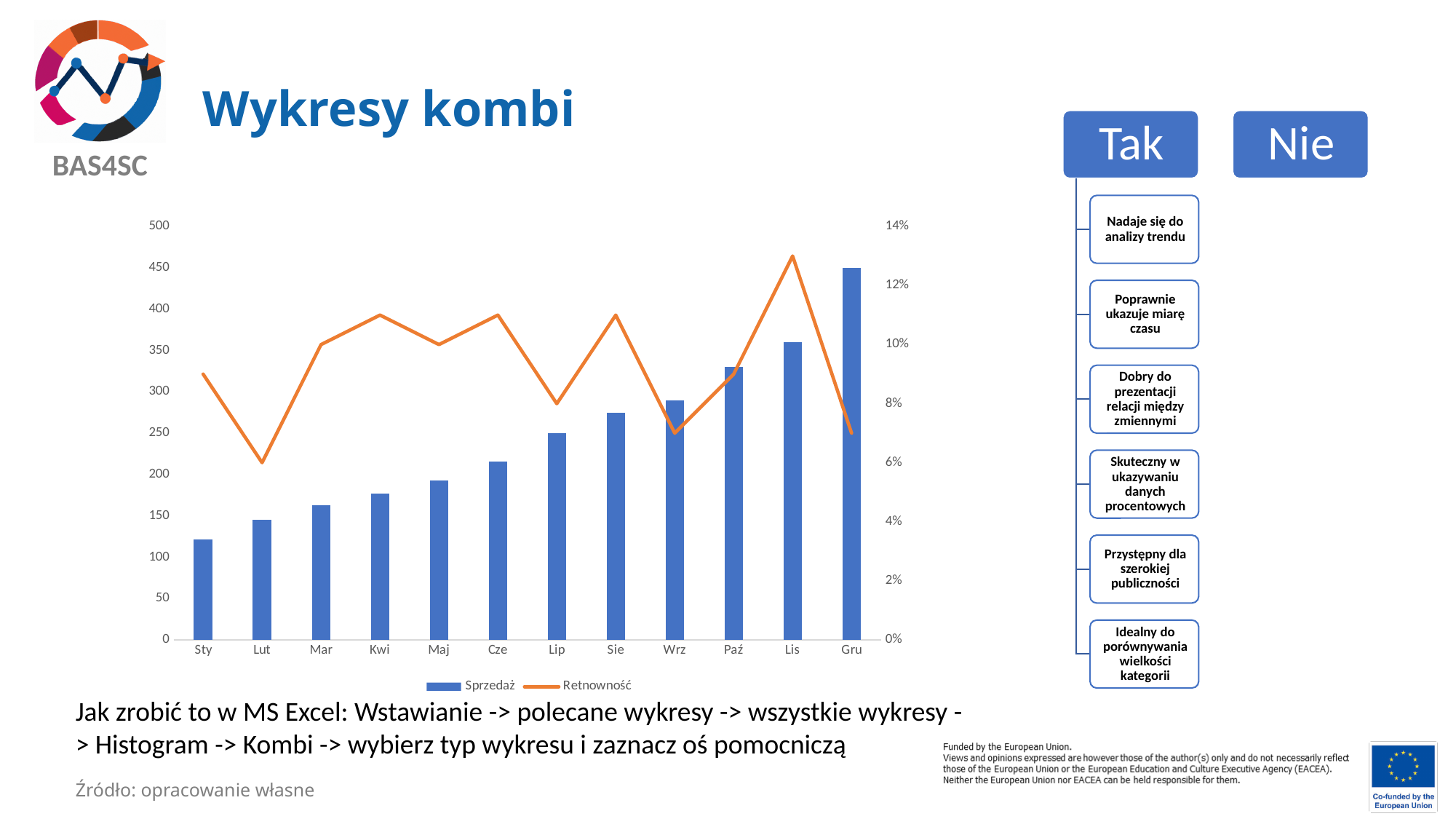
Is the Retnowność value for Lis greater or less than 12%? greater What kind of chart is shown on the slide? A combination chart with bars and a line Do the Sprzedaż bars generally rise or fall from Sty to Gru? Rise Which month has the lowest Sprzedaż bar? Sty How many series does the legend list? 2 Is the Sprzedaż value for Gru greater or less than 400? greater In which month does the Retnowność line reach its lowest point? Lut Which month has the highest Sprzedaż bar? Gru How many categories (months) are shown on the x axis? 12 In which month does the Retnowność line reach its highest point? Lis Is the Sprzedaż value for Sty greater or less than 150? less Which series is drawn as an orange line? Retnowność